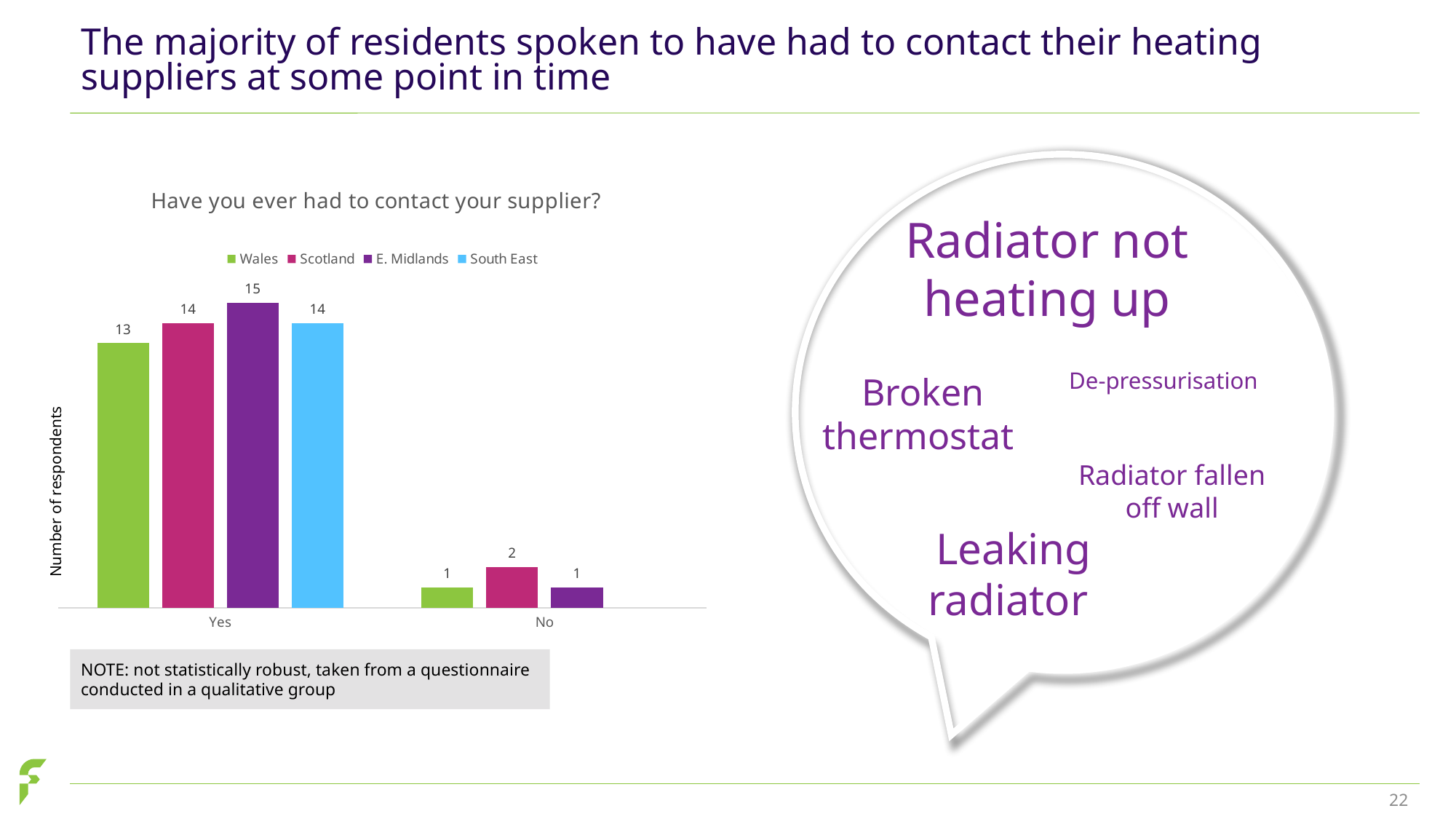
What is the value for Scotland in the No category? 2 What is the title of the chart? Have you ever had to contact your supplier? What is the value for E. Midlands in the Yes category? 15 Which region has the highest value in the Yes category? E. Midlands How many series does the legend list? 4 What is the difference between the E. Midlands and Wales values in the Yes category? 2 Which region has the lowest value in the Yes category? Wales How many categories are shown on the x axis? 2 What is the value for South East in the Yes category? 14 Which is larger in the No category: Scotland or Wales? Scotland What kind of chart is shown on the slide? Bar chart What is the value for Wales in the Yes category? 13